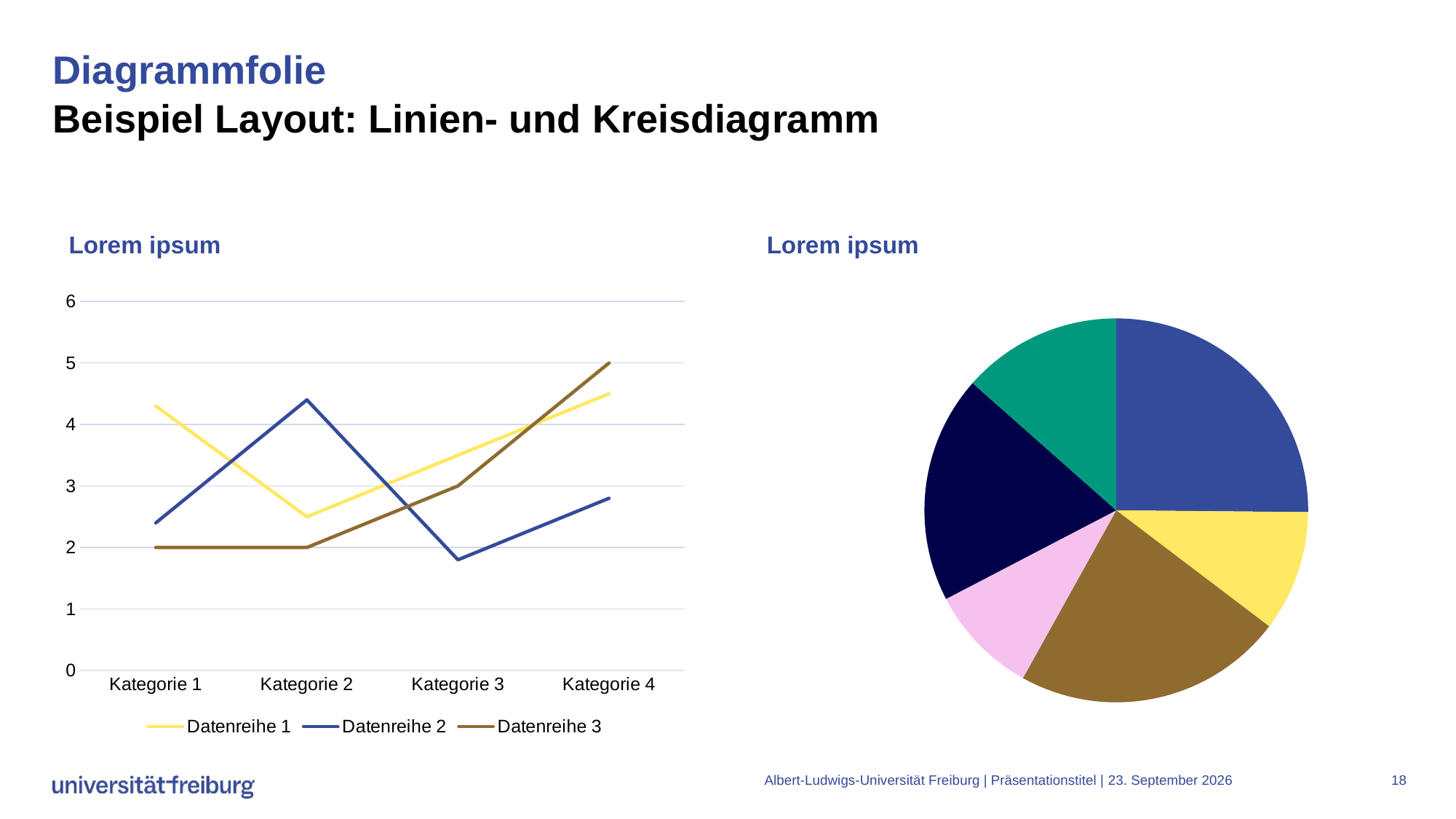
What kind of chart is the chart on the right of the slide? pie chart In the line chart on the left, which series has the higher value at Kategorie 4, Datenreihe 2 or Datenreihe 3? Datenreihe 3 What kind of chart is the chart on the left of the slide? line chart In the line chart on the left, at which category does Datenreihe 2 reach its lowest value? Kategorie 3 In the line chart on the left, what is the value of Datenreihe 3 at Kategorie 1? 2 In the line chart on the left, how many series does the legend list? 3 In the line chart on the left, does Datenreihe 3 rise or fall from Kategorie 2 to Kategorie 4? rise In the line chart on the left, how many categories are shown on the x axis? 4 In the line chart on the left, is the value of Datenreihe 2 at Kategorie 3 greater or less than 2? less In the line chart on the left, what is the value of Datenreihe 3 at Kategorie 4? 5 How many slices does the pie chart on the right have? 6 In the line chart on the left, is the value of Datenreihe 2 at Kategorie 2 greater or less than 4? greater